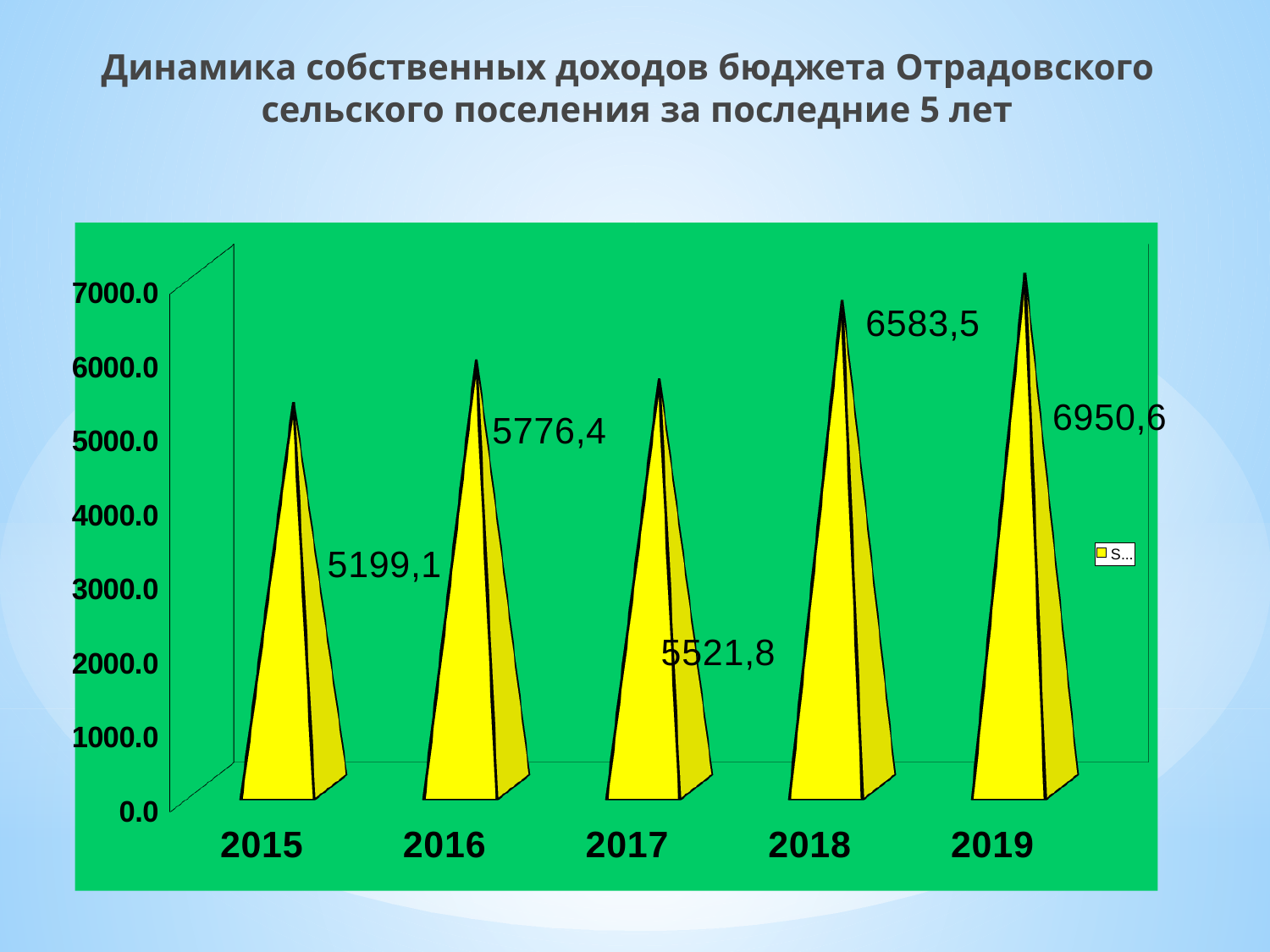
What is the value for 2015? 5199,1 What is the value for 2018? 6583,5 Is the value for 2019 greater or less than 7000? less Which is larger, the value for 2016 or the value for 2017? 2016 Which year has the lowest value? 2015 How many years are shown on the x axis? 5 What kind of chart is shown on the slide? bar chart What is the difference between the values for 2016 and 2015? 577,3 Which year has the highest value? 2019 What is the value for 2017? 5521,8 Does the value rise or fall from 2016 to 2017? fall What is the difference between the values for 2019 and 2018? 367,1